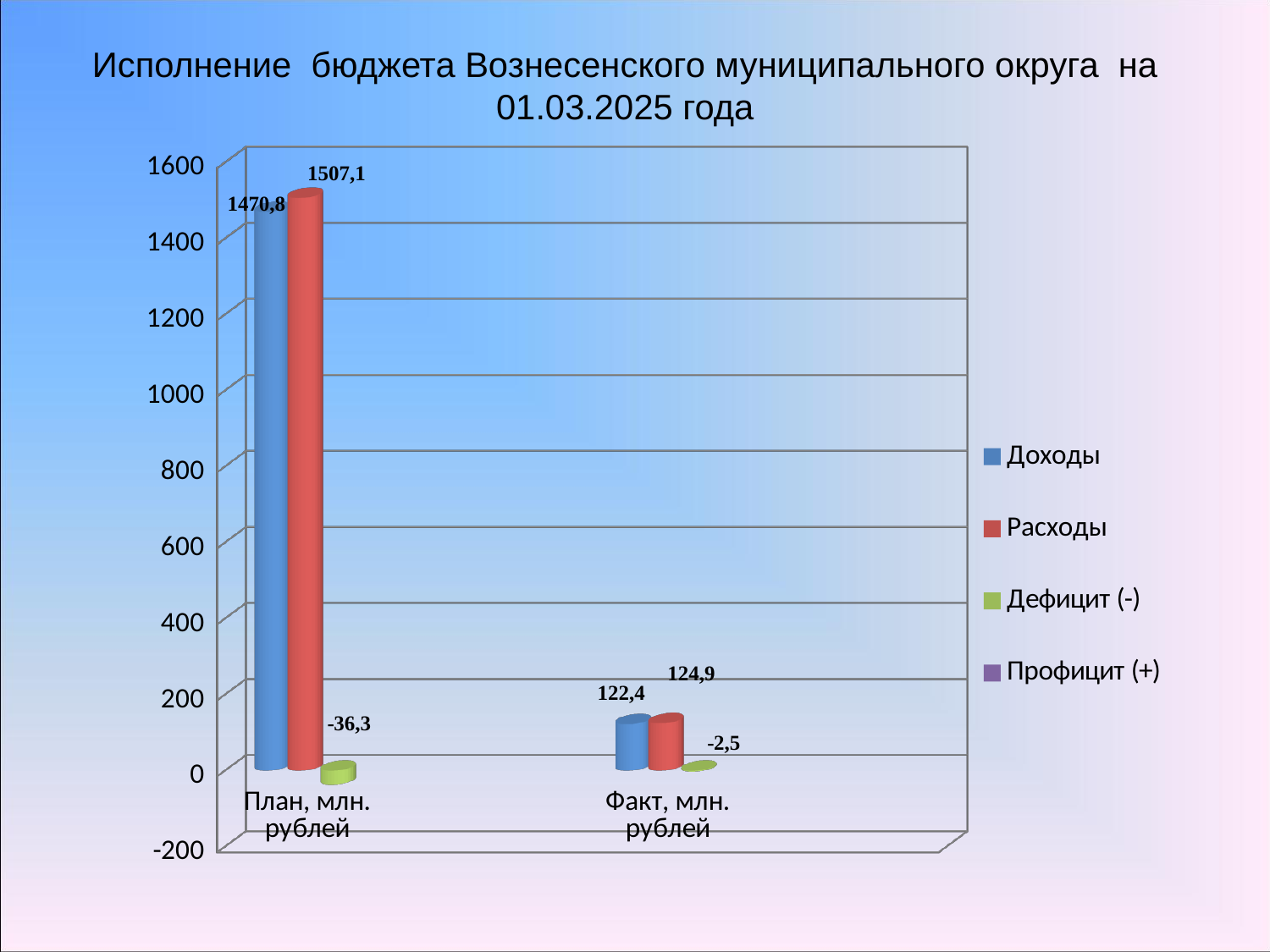
How many categories are shown on the x axis? 2 What is the value of Расходы for План, млн. рублей? 1507,1 Which series has the highest value for План, млн. рублей? Расходы How many series does the legend list? 4 Which is larger for Факт, млн. рублей: Доходы or Расходы? Расходы What is the value of Дефицит (-) for План, млн. рублей? -36,3 What is the value of Дефицит (-) for Факт, млн. рублей? -2,5 Which colour represents Доходы in the legend? Blue What is the value of Доходы for План, млн. рублей? 1470,8 What is the value of Расходы for Факт, млн. рублей? 124,9 What is the difference between Расходы and Доходы for План, млн. рублей? 36,3 What kind of chart is shown on the slide? Bar chart